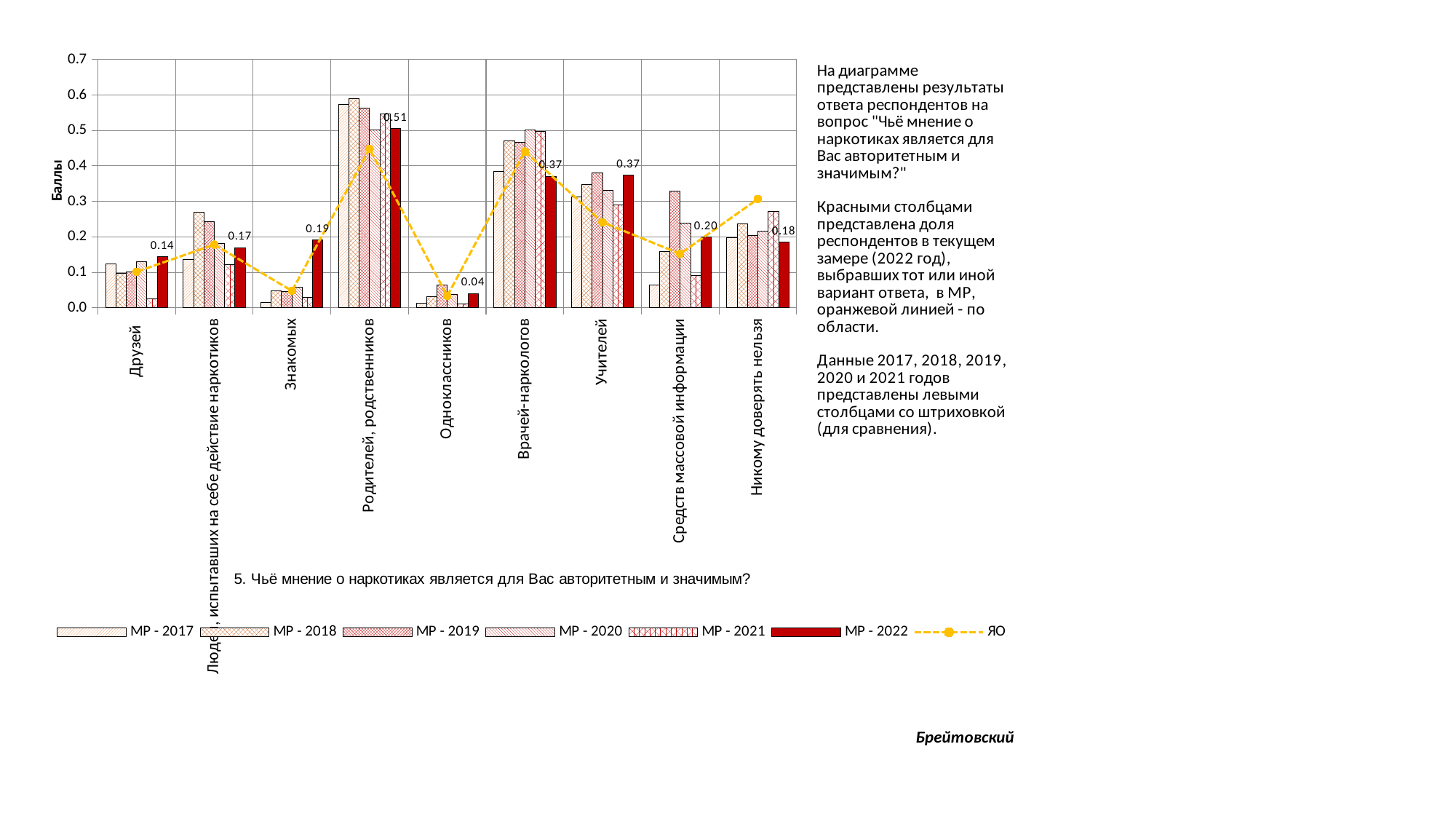
Which category has the highest MP - 2022 value? Родителей, родственников What is the label of the vertical axis? Баллы How many categories are shown on the x axis? 9 What is the MP - 2022 value for Родителей, родственников? 0.51 Which is larger for MP - 2022: Знакомых or Друзей? Знакомых Which category has the lowest MP - 2022 value? Одноклассников What is the MP - 2022 value for Средств массовой информации? 0.20 Is the ЯО value for Никому доверять нельзя greater or less than 0.2? greater What kind of chart is shown on the slide? Combined bar and line chart What is the MP - 2022 value for Одноклассников? 0.04 What is the difference between the MP - 2022 values for Родителей, родственников and Врачей-наркологов? 0.14 How many series does the legend list? 7